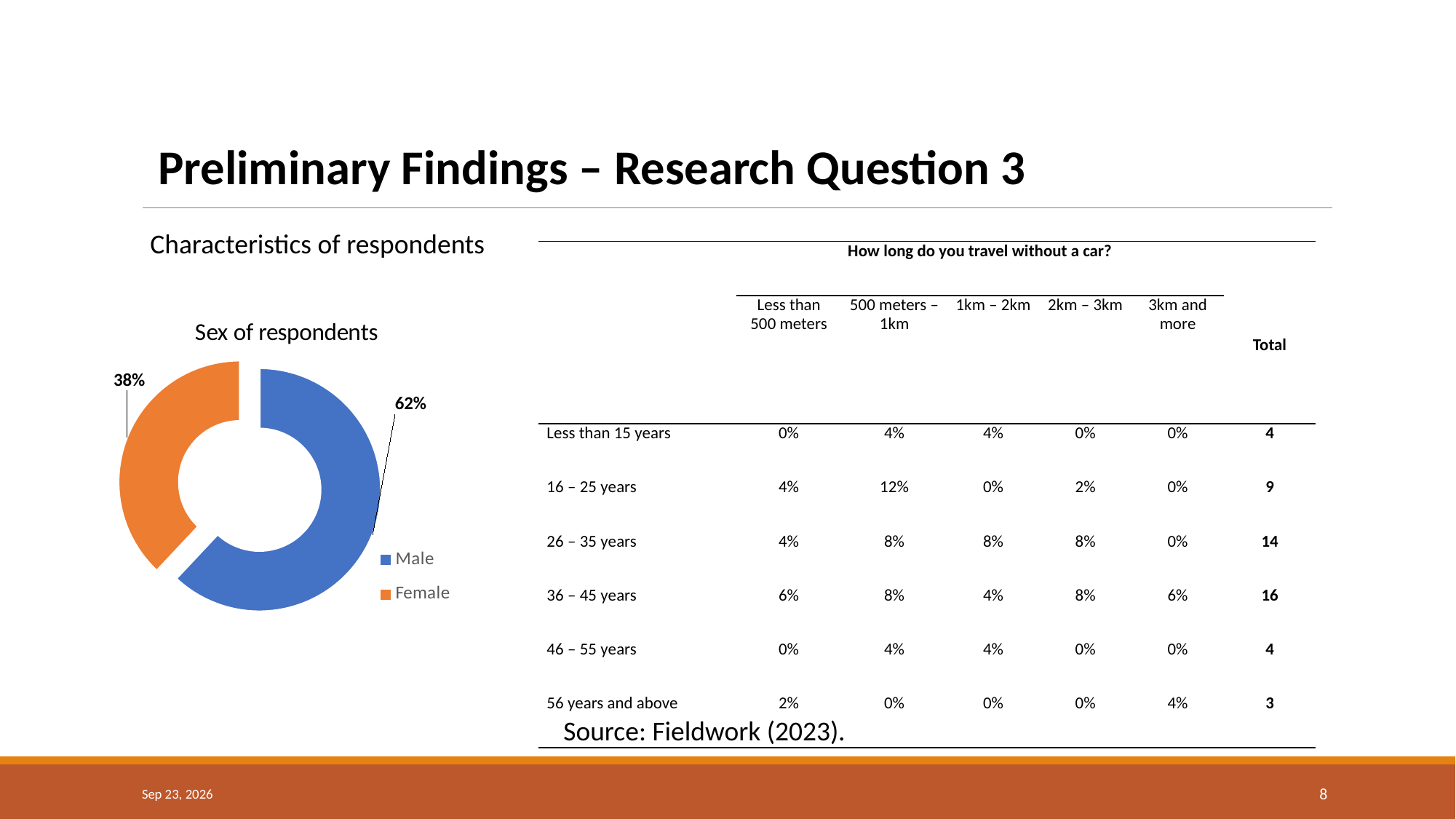
In the 'Sex of respondents' chart, which colour represents Female? orange What kind of chart is the 'Sex of respondents' chart? doughnut chart In the 'Sex of respondents' chart, is the Male share larger or smaller than the Female share? larger What is the title of the chart on the slide? Sex of respondents In the 'Sex of respondents' chart, is the Male share greater or less than 50%? greater How many entries does the legend of the 'Sex of respondents' chart list? 2 In the 'Sex of respondents' chart, what is the difference in percentage points between the Male and Female shares? 24 In the 'Sex of respondents' chart, which category has the smallest share? Female In the 'Sex of respondents' chart, what share of respondents are Female? 38% In the 'Sex of respondents' chart, what share of respondents are Male? 62% In the 'Sex of respondents' chart, which category has the largest share? Male How many categories does the 'Sex of respondents' chart show? 2